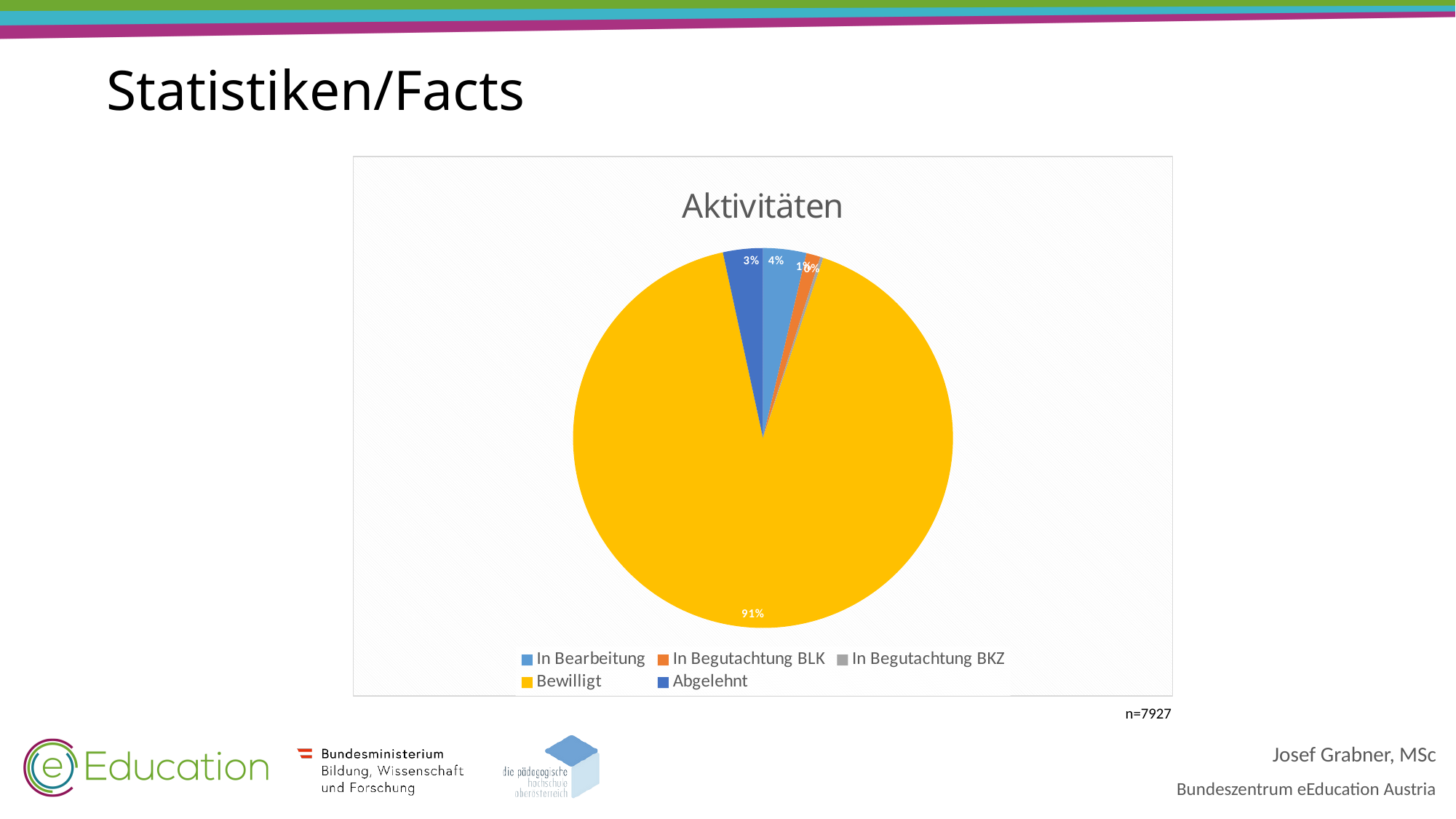
Which category has the largest slice of the pie? Bewilligt What share of the pie does In Begutachtung BLK have? 1% Which slice is larger, In Bearbeitung or Abgelehnt? In Bearbeitung What share of the pie does In Bearbeitung have? 4% What is the title of the chart? Aktivitäten What share of the pie does Abgelehnt have? 3% What colour is the Bewilligt slice? yellow Which category has the smallest slice of the pie? In Begutachtung BKZ What kind of chart is shown on the slide? pie chart How many percentage points larger is the Bewilligt slice than the In Bearbeitung slice? 87 percentage points How many categories does the legend list? 5